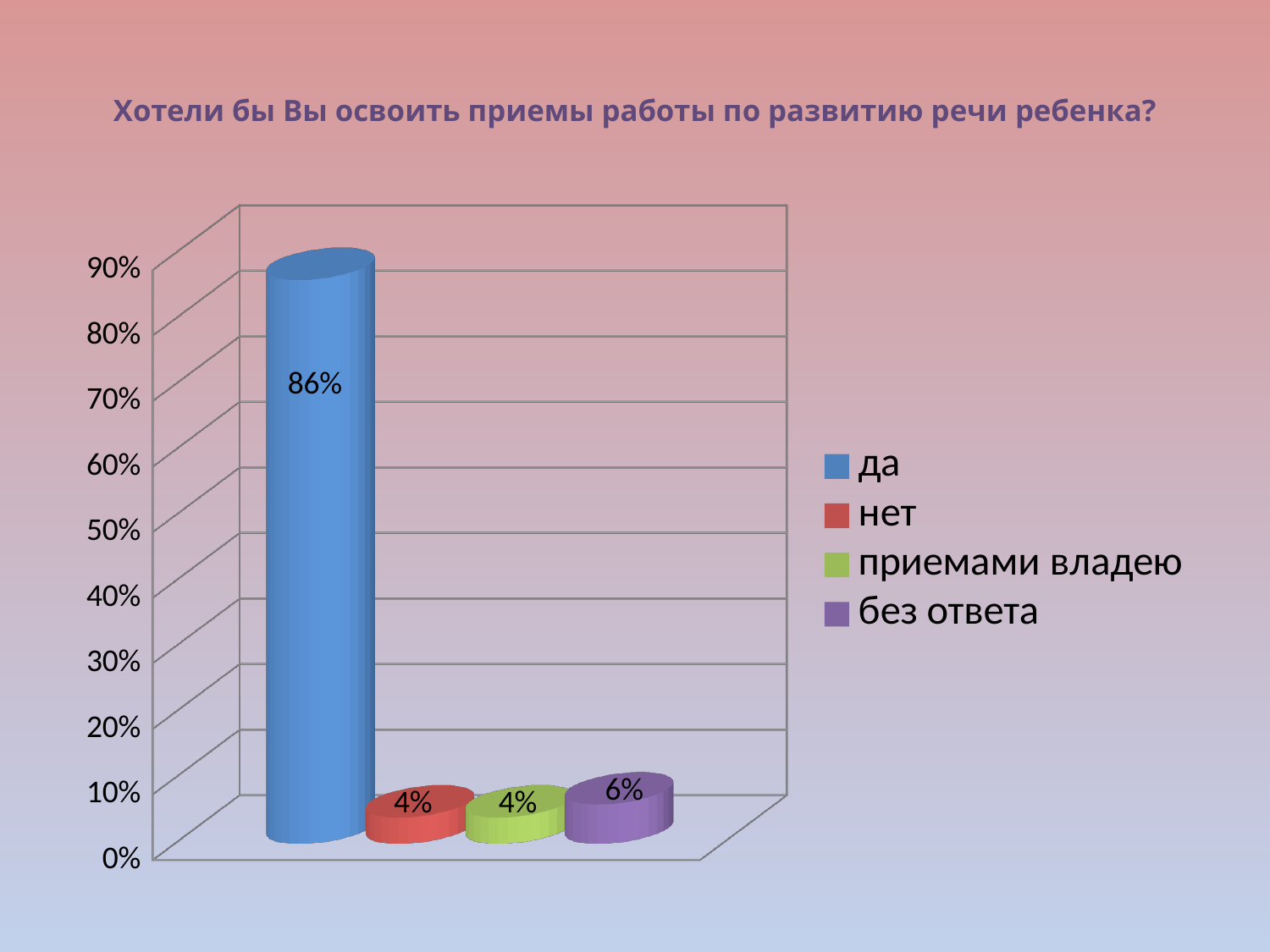
What is the difference between the values for "да" and "без ответа"? 80% What kind of chart is shown on the slide? bar chart What is the value for "без ответа"? 6% Which is larger, the value for "без ответа" or the value for "нет"? без ответа Which category has the highest value? да What is the title of the chart? Хотели бы Вы освоить приемы работы по развитию речи ребенка? What is the value for "приемами владею"? 4% Is the value for "да" greater or less than 80%? greater What is the value for "нет"? 4% What is the value for "да"? 86% Is the value for "без ответа" greater or less than 10%? less How many categories are shown in the chart? 4